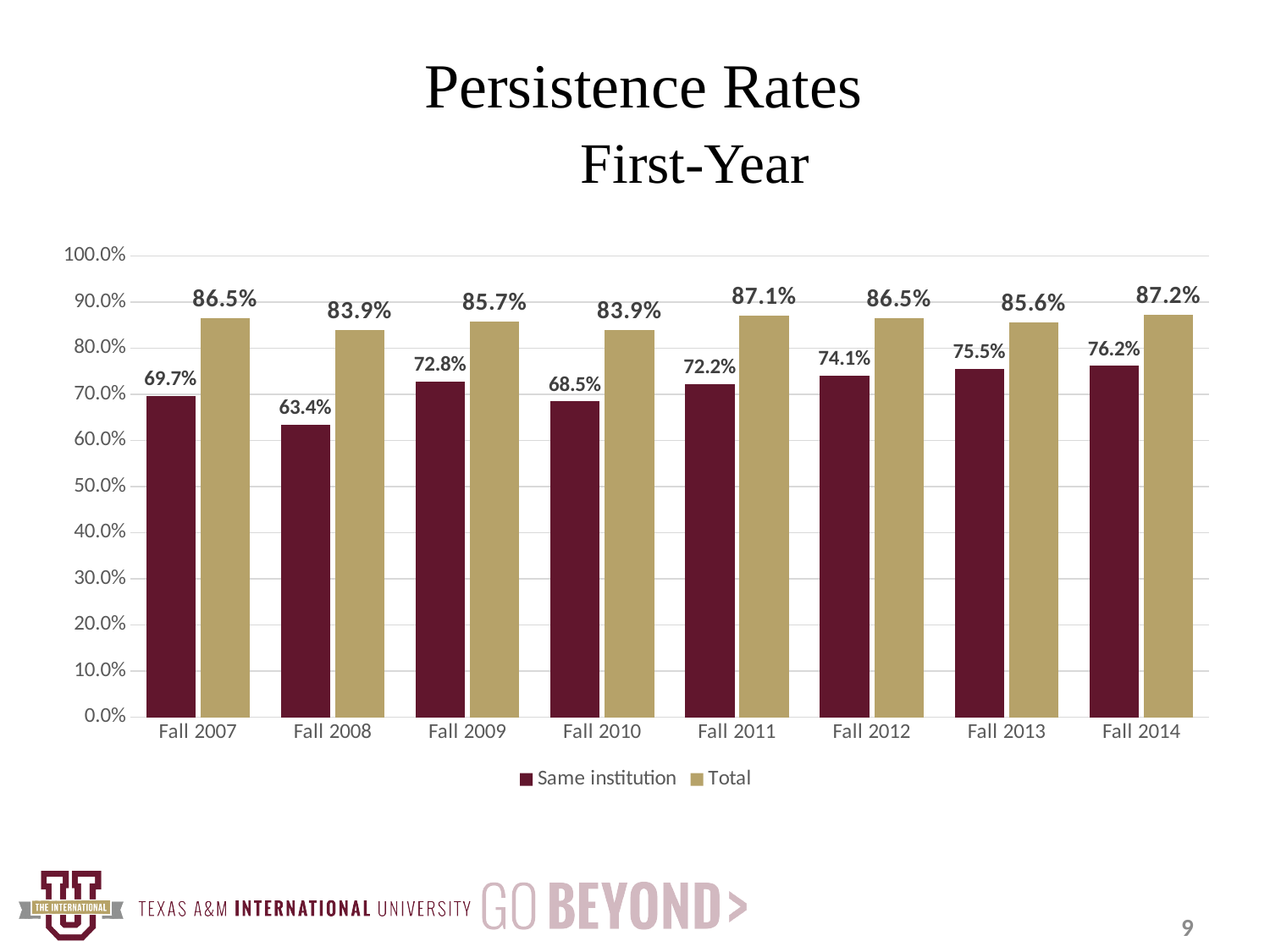
What are the two series named in the legend? Same institution and Total What is the Same institution persistence rate for Fall 2014? 76.2% How many series does the legend list? 2 Which cohort has the lowest Same institution persistence rate? Fall 2008 What is the Total persistence rate for Fall 2011? 87.1% What kind of chart is shown on the slide? Bar chart Which cohort has the highest Total persistence rate? Fall 2014 What is the difference between the Total and Same institution rates for Fall 2007? 16.8% How many cohorts (categories) are shown on the x axis? 8 What is the Same institution persistence rate for Fall 2008? 63.4% Which is larger, the Same institution rate for Fall 2009 or for Fall 2010? Fall 2009 Is the Same institution rate for Fall 2013 greater or less than 70.0%? greater